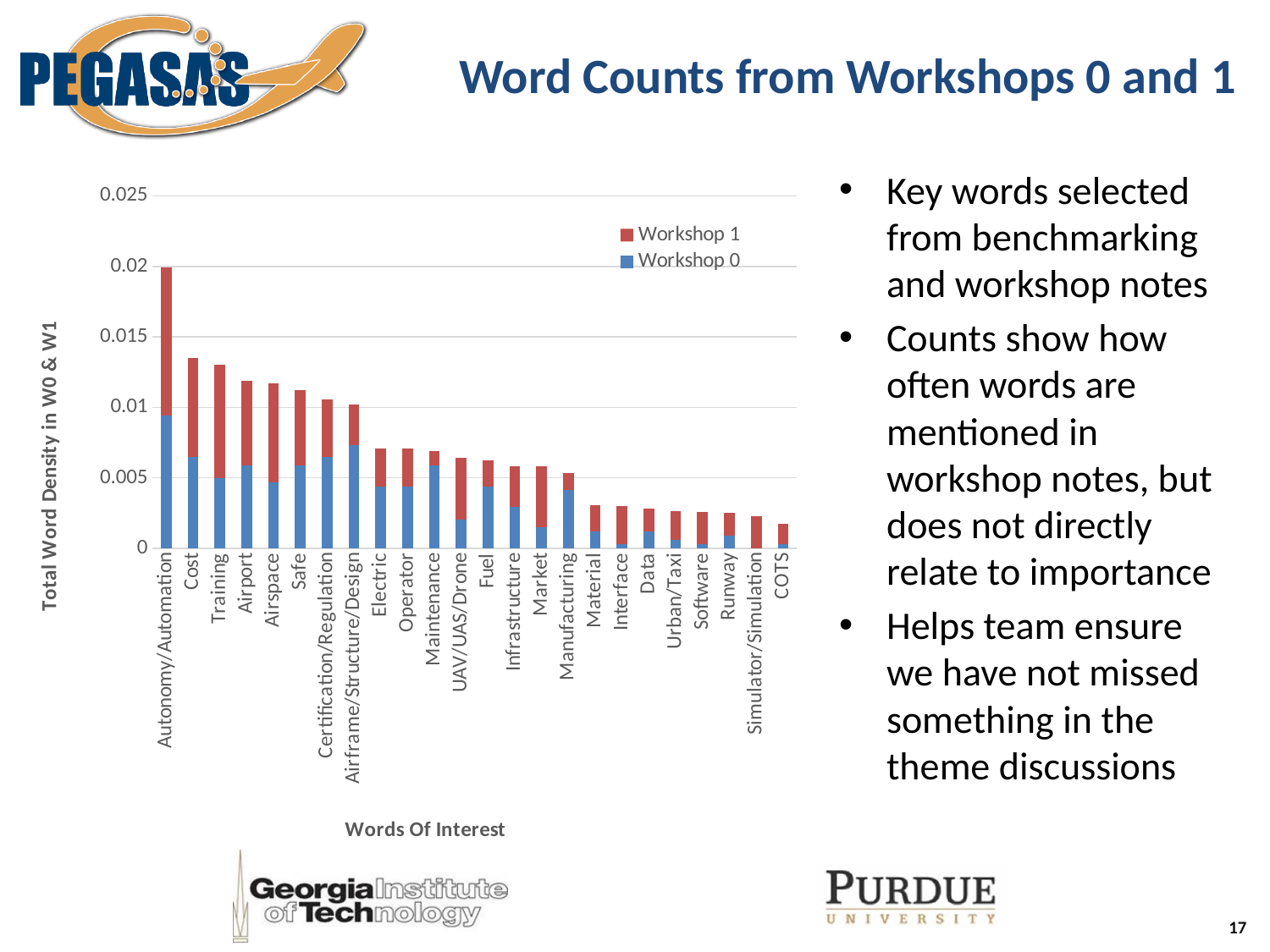
Is the total value for Autonomy/Automation greater or less than 0.015? greater Do the total bar heights rise or fall moving from left to right along the x axis? Fall Which word of interest has the lowest total word density? COTS Is the Workshop 0 value for Autonomy/Automation greater or less than 0.005? greater Is the total value for Cost greater or less than 0.01? greater How many words of interest are plotted along the x axis? 24 Which has the larger total word density, Cost or Electric? Cost How many series does the chart legend list? 2 What are the two entries in the chart legend? Workshop 1 and Workshop 0 What kind of chart is shown on the slide? Stacked bar chart Which word of interest has the highest total word density? Autonomy/Automation